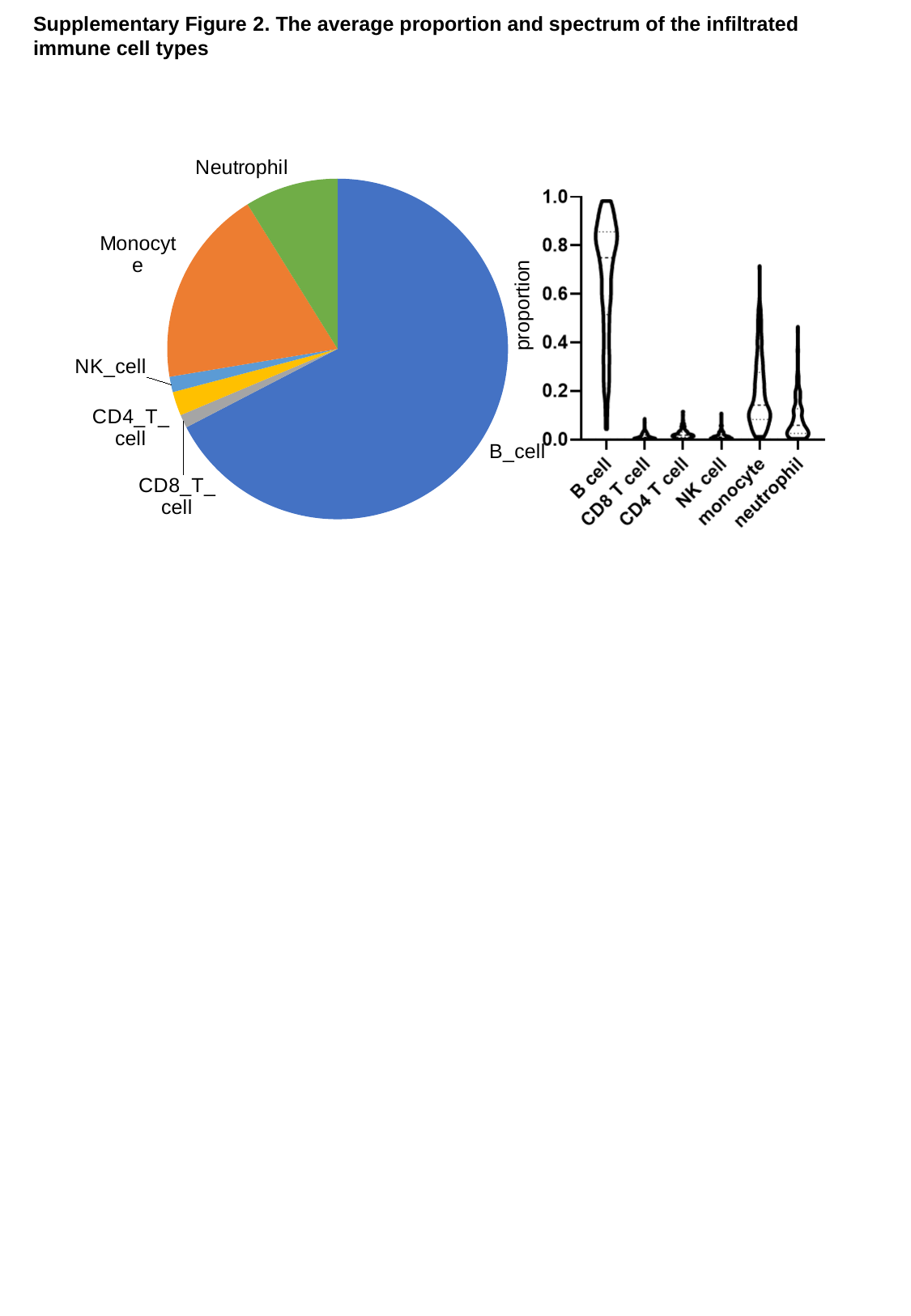
In the pie chart on the left, which cell type has the largest slice? B_cell In the violin plot on the right, what is the label of the y axis? proportion In the violin plot on the right, is the maximum proportion for monocyte greater or less than 0.8? less What kind of chart is the chart on the left of the slide? pie chart In the violin plot on the right, how many cell types are shown on the x axis? 6 In the violin plot on the right, is the maximum proportion for B cell greater or less than 0.8? greater In the pie chart on the left, which slice is larger, Neutrophil or CD4_T_cell? Neutrophil In the violin plot on the right, which cell type reaches the highest proportion? B cell In the pie chart on the left, which slice is larger, B_cell or Monocyte? B_cell In the pie chart on the left, how many cell types (slices) are shown? 6 In the pie chart on the left, which slice is larger, Monocyte or Neutrophil? Monocyte In the pie chart on the left, what colour is the B_cell slice? blue